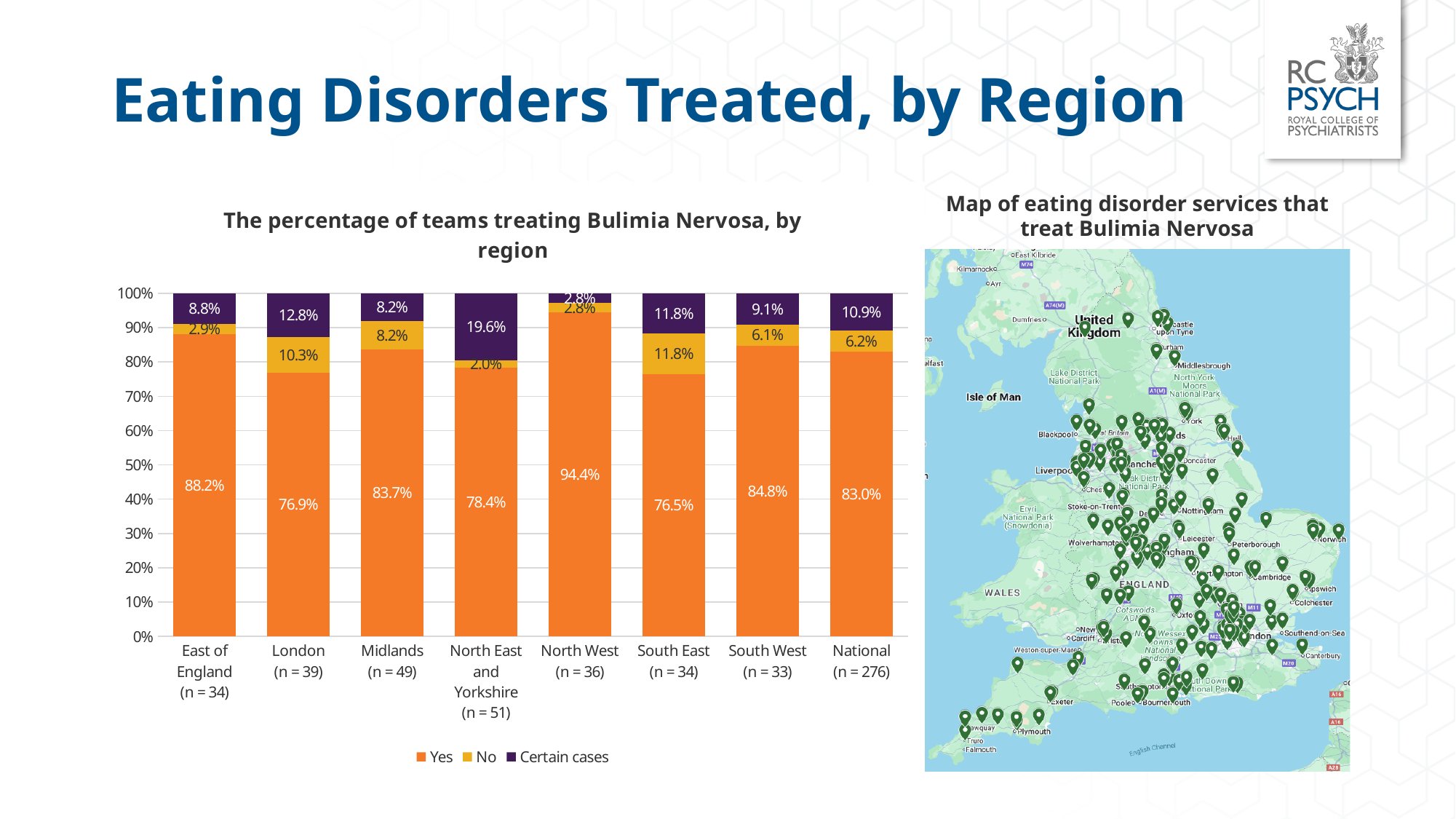
Which region has the lowest "Certain cases" percentage? North West How many series does the legend list? 3 What is the "No" percentage for London? 10.3% What is the difference in percentage points between the "Yes" values for the North West and the South East? 17.9 percentage points Is the "Yes" percentage larger for the South West or for the Midlands? South West How many region categories (including National) are shown on the x axis? 8 What is the national "Yes" percentage for teams treating Bulimia Nervosa? 83.0% What is the "Certain cases" percentage for North East and Yorkshire? 19.6% What percentage of teams in the North West answered "Yes" to treating Bulimia Nervosa? 94.4% Which region has the highest "Yes" percentage? North West Which region has the highest "Certain cases" percentage? North East and Yorkshire What type of chart is used to show the percentage of teams treating Bulimia Nervosa by region? Stacked bar chart